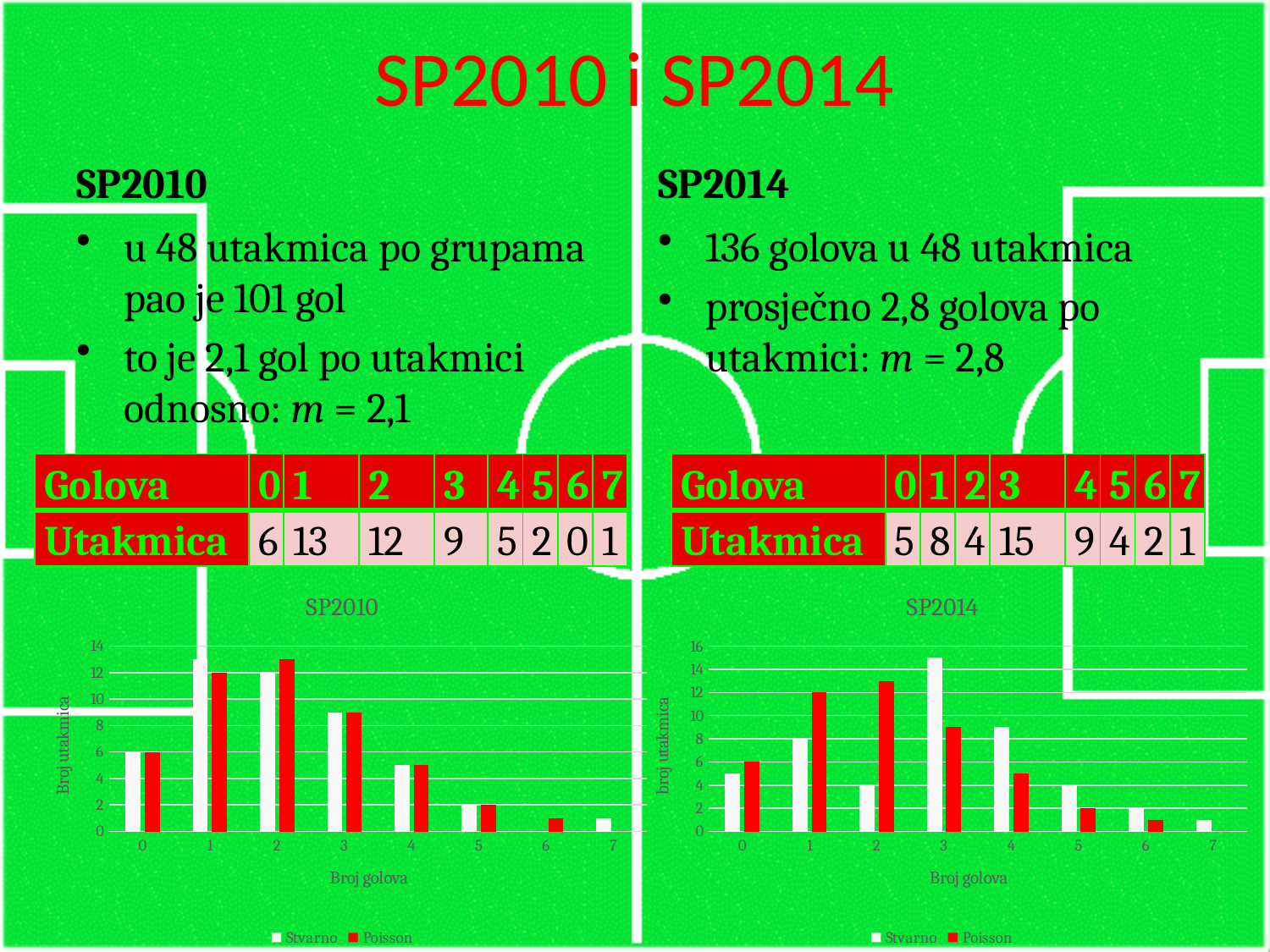
In the SP2010 chart, what is the Stvarno value for 1 goal? 13 In the SP2014 chart, do the Stvarno values rise or fall from 3 goals to 7 goals? fall In the SP2014 chart, what is the difference between the Stvarno values for 3 goals and 4 goals? 6 In the SP2014 chart, what is the Stvarno value for 3 goals? 15 How many series does the legend of the SP2014 chart list? 2 What kind of chart is the SP2010 chart? bar chart How many categories are shown on the x axis of the SP2014 chart? 8 What is the x-axis title of the SP2010 chart? Broj golova In the SP2010 chart, which number of goals has the lowest Stvarno value? 6 In the SP2010 chart, which number of goals has the highest Stvarno value? 1 In the SP2014 chart, which is larger for 2 goals, Stvarno or Poisson? Poisson In the SP2014 chart, is the Poisson value for 2 goals greater or less than 10? greater